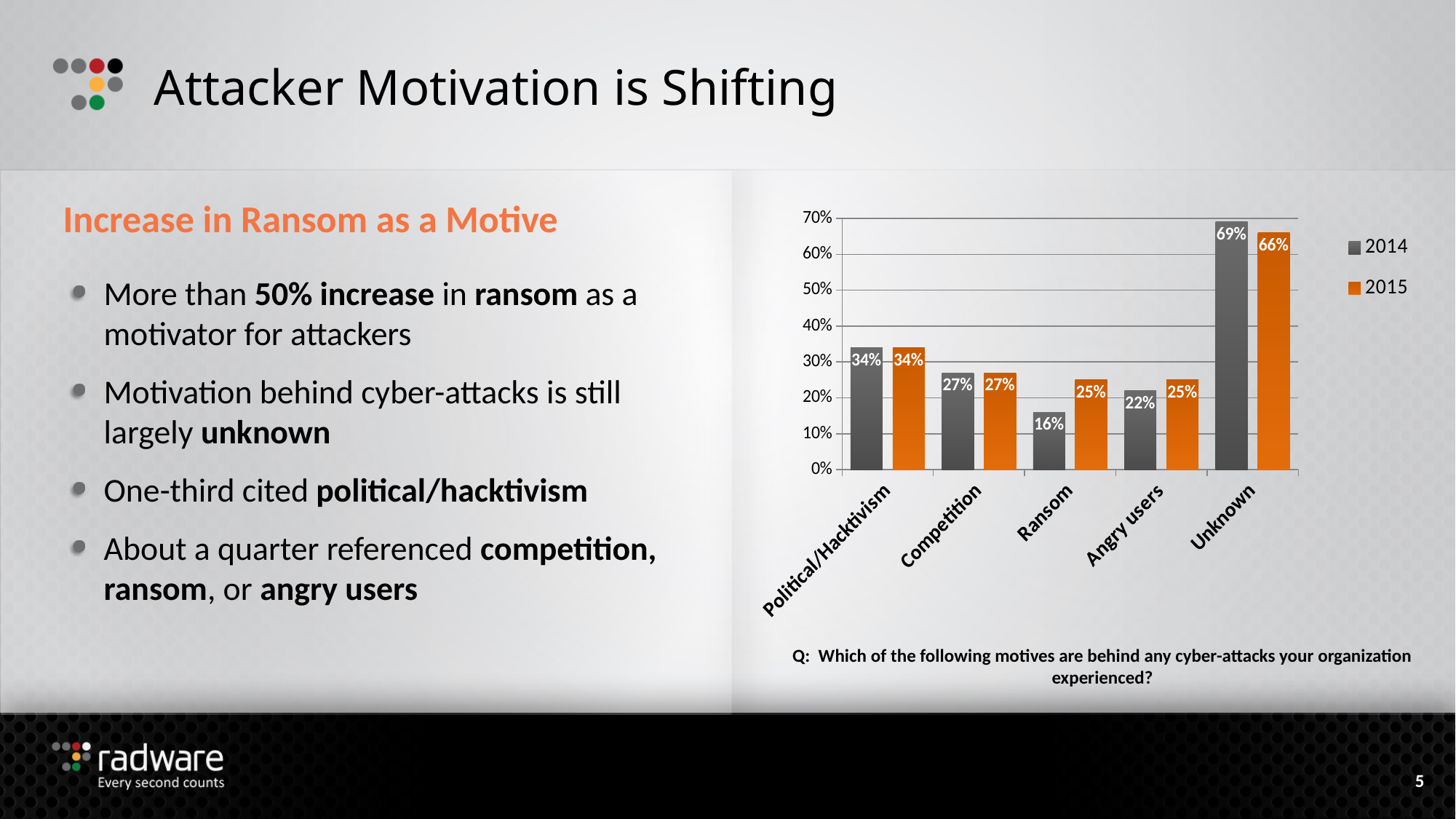
Which is larger, the 2014 value for Competition or the 2014 value for Ransom? 2014 value for Competition Is the 2015 value for Unknown greater or less than 60%? greater What is the 2014 value for Angry users? 22% Which category has the highest 2015 value? Unknown How many categories are shown on the x axis? 5 What is the difference between the 2015 and 2014 values for Ransom? 9% What is the 2015 value for Ransom? 25% What kind of chart is shown on the slide? bar chart Which category has the lowest 2014 value? Ransom What is the 2014 value for Unknown? 69% How many series does the legend list? 2 What is the difference between the 2014 and 2015 values for Unknown? 3%